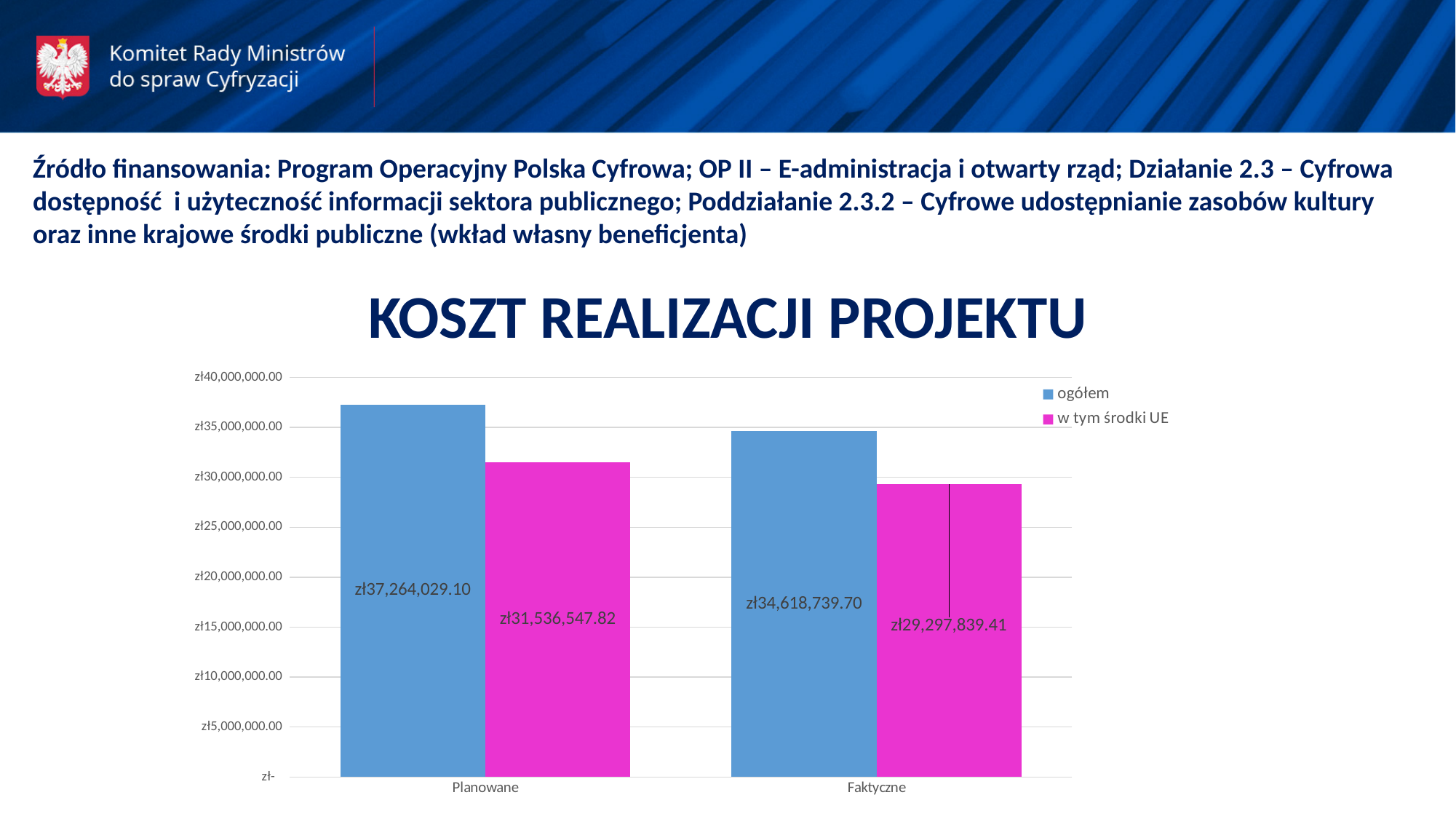
Which bar has the lowest value in the chart? w tym środki UE for Faktyczne What is the value of 'ogółem' for Faktyczne? zł34,618,739.70 What is the value of 'w tym środki UE' for Planowane? zł31,536,547.82 How many categories are shown on the x axis? 2 Which is larger: 'w tym środki UE' for Planowane or 'ogółem' for Faktyczne? ogółem for Faktyczne What type of chart is shown on the slide? bar chart What is the value of 'w tym środki UE' for Faktyczne? zł29,297,839.41 What is the value of 'ogółem' for Planowane? zł37,264,029.10 Which bar has the highest value in the chart? ogółem for Planowane What is the difference between 'ogółem' and 'w tym środki UE' for Faktyczne? zł5,320,900.29 What is the difference between 'ogółem' for Planowane and 'ogółem' for Faktyczne? zł2,645,289.40 How many series does the legend list? 2